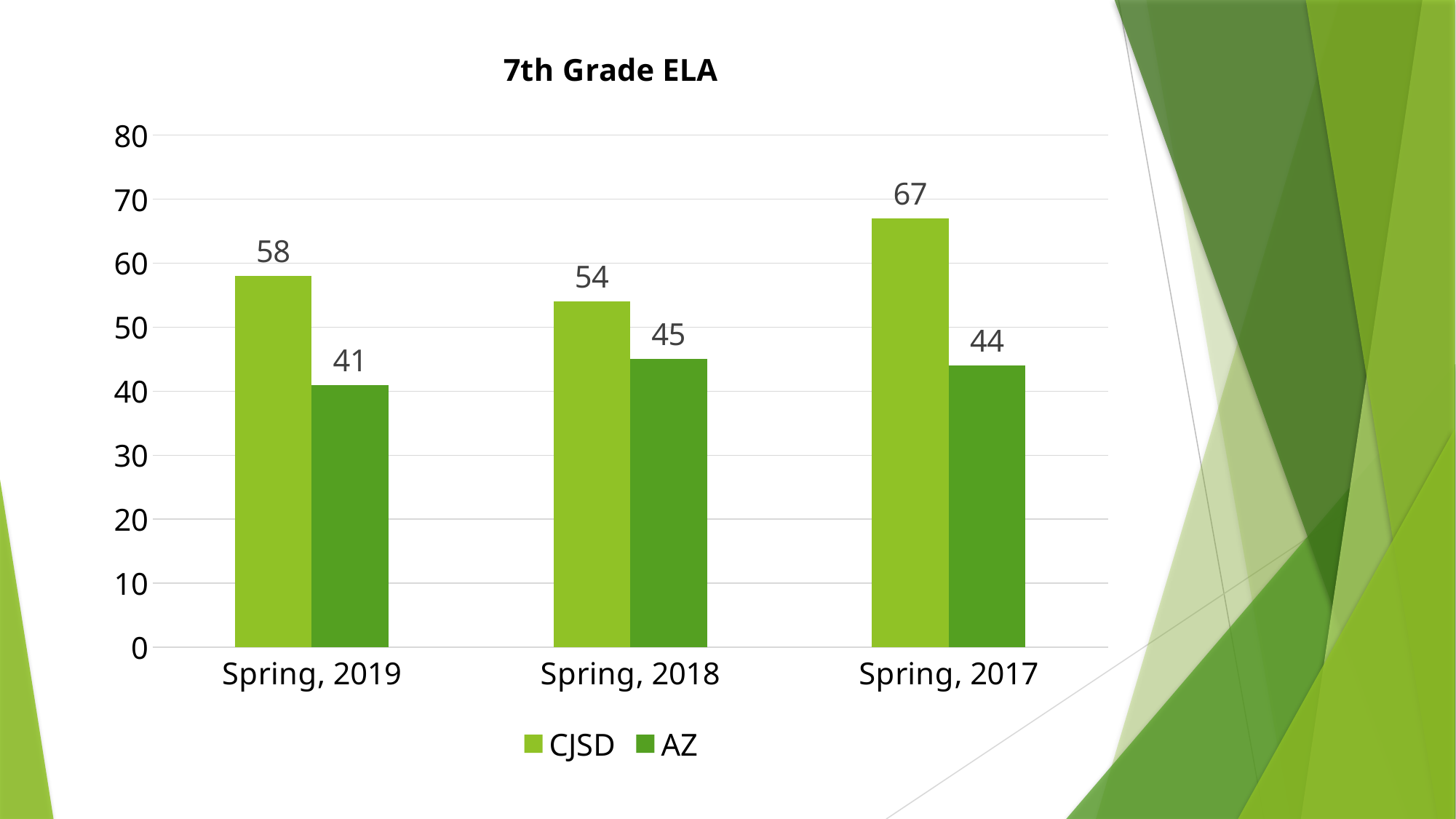
What is the CJSD value for Spring, 2017? 67 What is the difference between the CJSD values for Spring, 2017 and Spring, 2018? 13 How many categories are shown on the x axis? 3 Which is larger, the AZ value for Spring, 2018 or the AZ value for Spring, 2017? Spring, 2018 What kind of chart is shown? Bar chart How many series does the legend list? 2 What is the CJSD value for Spring, 2019? 58 What is the AZ value for Spring, 2018? 45 What is the difference between the CJSD and AZ values for Spring, 2019? 17 Which category has the lowest AZ value? Spring, 2019 Which category has the highest CJSD value? Spring, 2017 What is the title of the chart? 7th Grade ELA